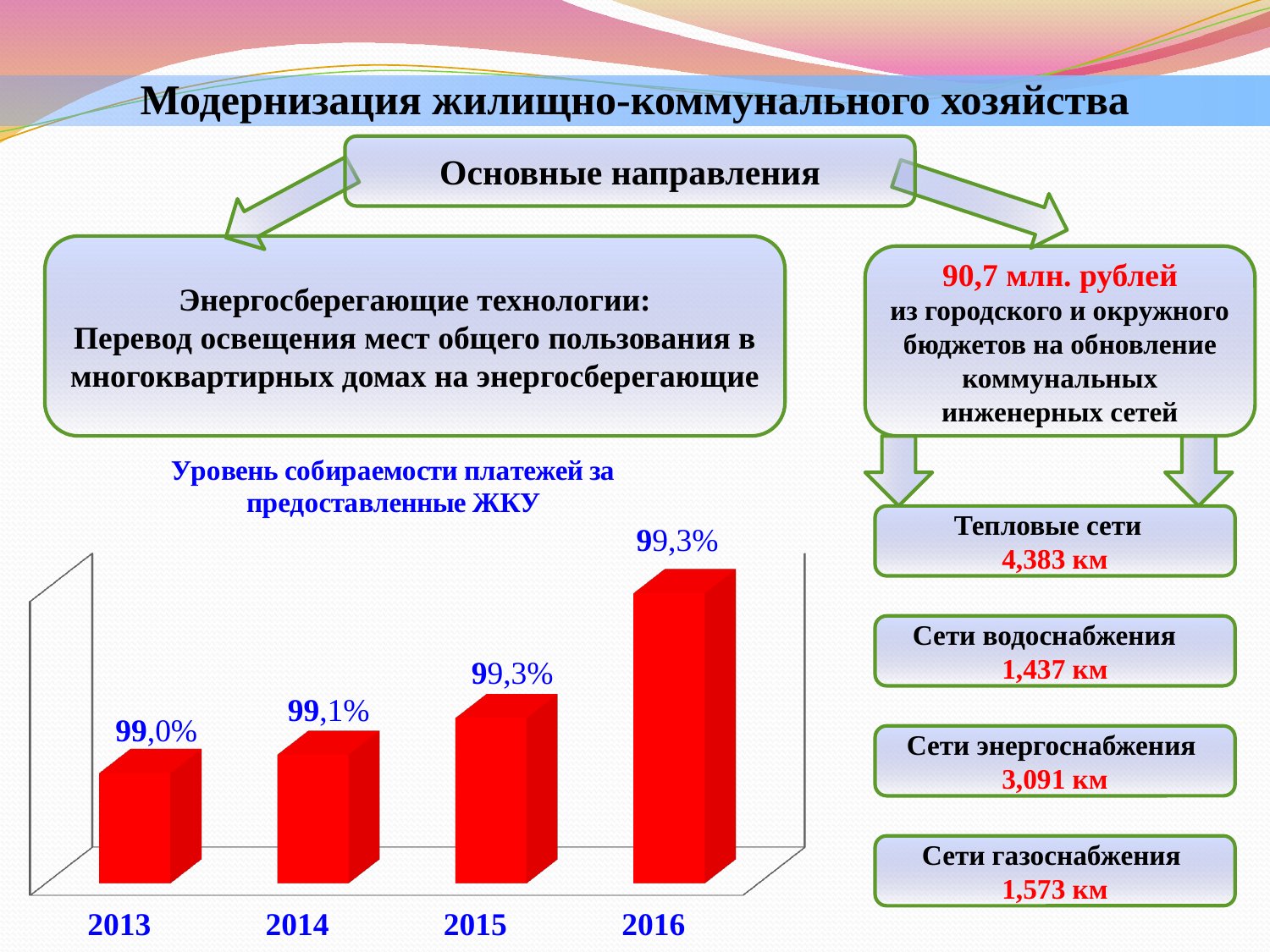
What is the difference between the values for 2015 and 2013 in the chart? 0,3 percentage points How many years are shown in the chart? 4 What is the value for 2016 in the chart? 99,3% What is the value for 2014 in the chart? 99,1% What kind of chart is shown on the slide? Bar chart What is the value for 2013 in the chart 'Уровень собираемости платежей за предоставленные ЖКУ'? 99,0% Which is larger in the chart, the value for 2013 or the value for 2014? 2014 What is the value for 2015 in the chart? 99,3% Do the values in the chart rise or fall from 2013 to 2016? Rise Which year has the lowest value in the chart? 2013 What is the title of the chart on the slide? Уровень собираемости платежей за предоставленные ЖКУ What is the difference between the values for 2014 and 2013 in the chart? 0,1 percentage points